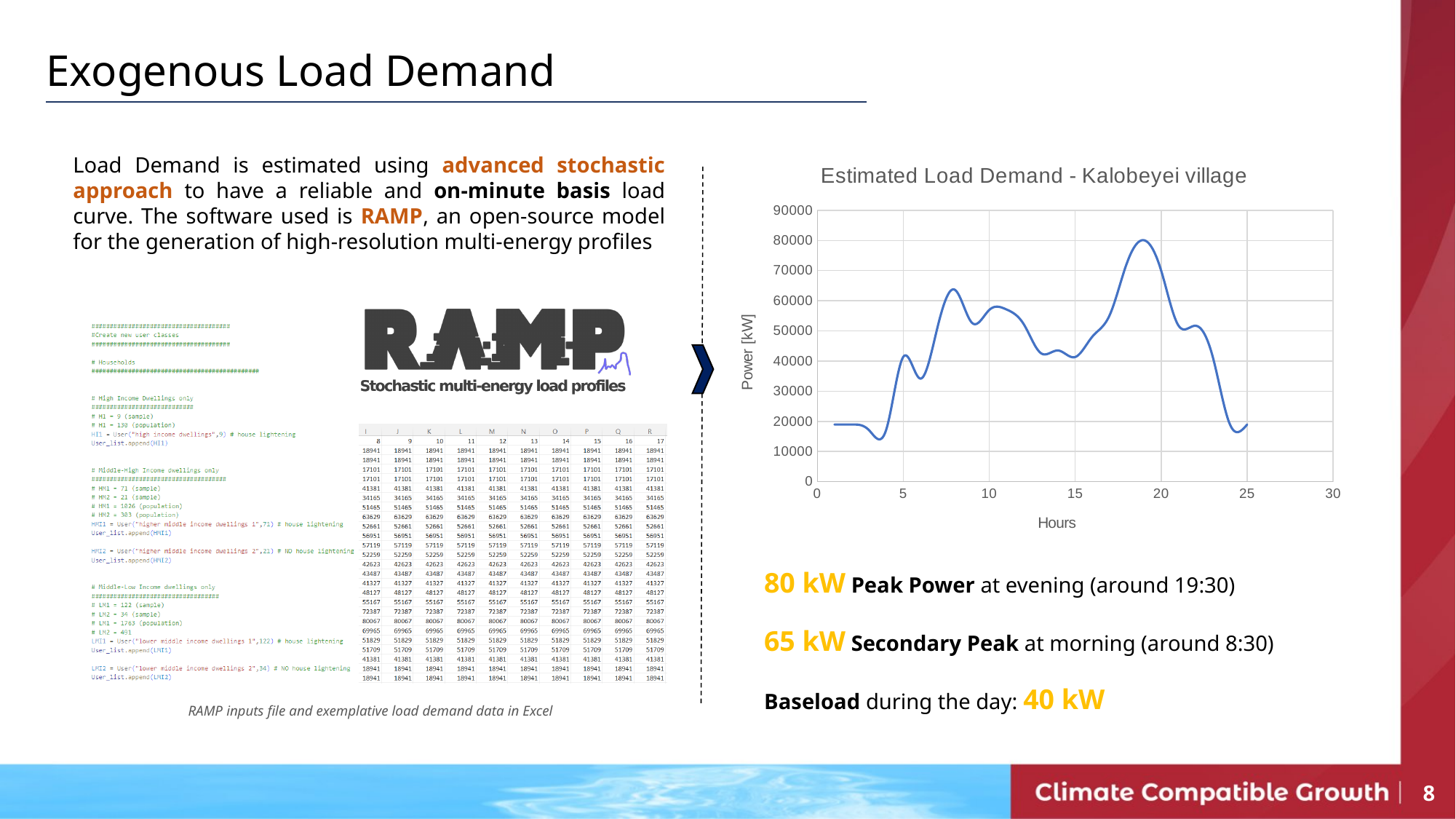
Is the value at hour 4 greater or less than 20000? less Which is larger, the value at hour 19 or the value at hour 8? hour 19 Is the value at hour 19 greater or less than 70000? greater What is the title of the chart on the slide? Estimated Load Demand - Kalobeyei village What is the label of the vertical axis of the chart? Power [kW] Between hour 19 and hour 24, does the line rise or fall? fall Which is larger, the value at hour 8 or the value at hour 15? hour 8 Is the value at hour 15 greater or less than 50000? less What kind of chart is shown on the slide? line chart